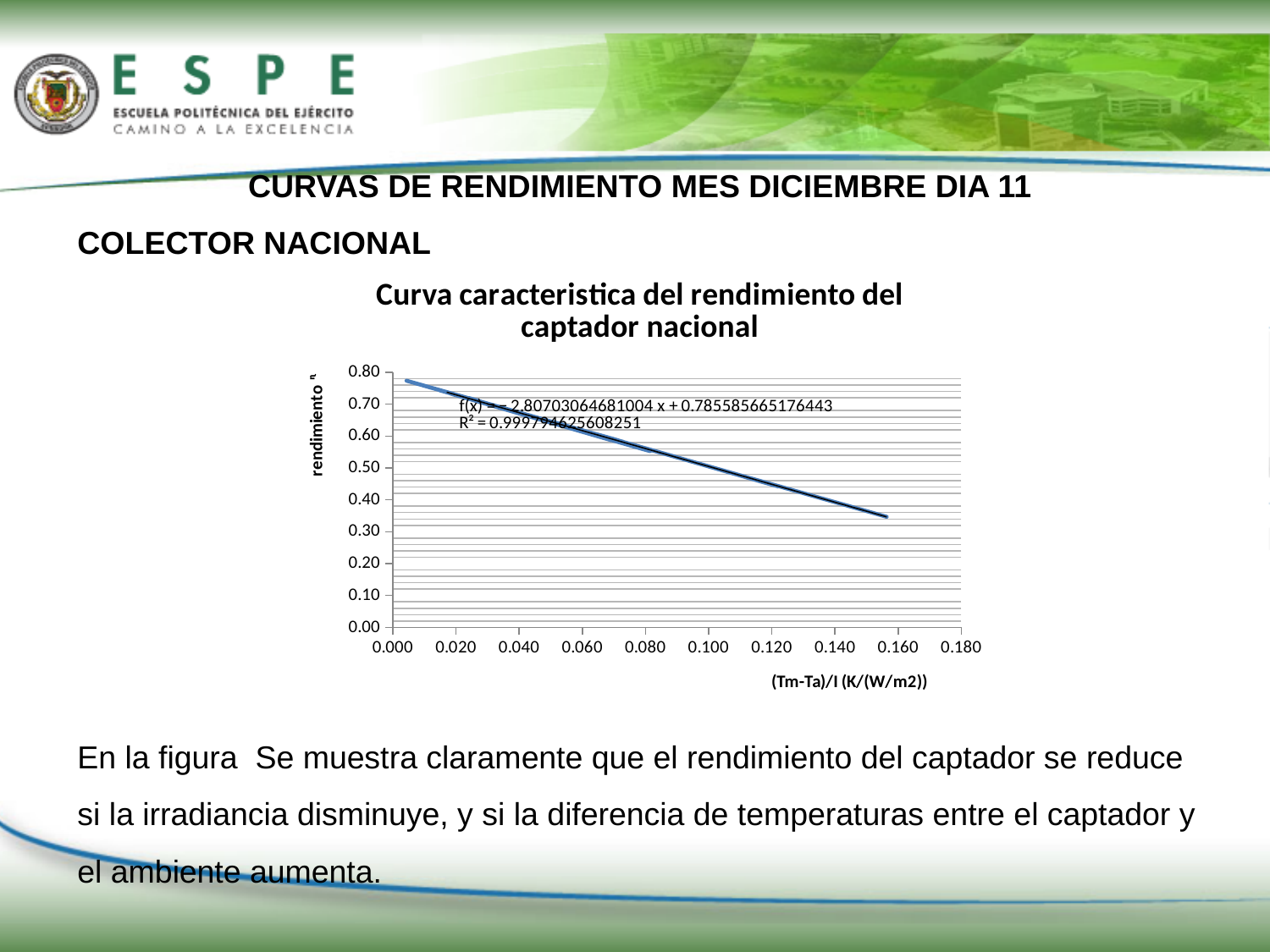
Is the rendimiento value at (Tm-Ta)/I = 0.120 greater or less than 0.50? less What is the label of the x axis of the chart? (Tm-Ta)/I (K/(W/m2)) What R² value is shown on the chart? 0.999794625608251 What is the maximum value shown on the x axis of the chart? 0.180 Is the rendimiento value at (Tm-Ta)/I = 0.020 greater or less than 0.70? greater What is the title of the chart? Curva caracteristica del rendimiento del captador nacional What is the maximum value shown on the y axis of the chart? 0.80 Is the rendimiento value at (Tm-Ta)/I = 0.040 greater or less than 0.60? greater Does the rendimiento value rise or fall as (Tm-Ta)/I increases along the x axis? fall What is the trendline equation shown on the chart? f(x) = − 2.80703064681004 x + 0.785585665176443 What kind of chart is shown on the slide? line chart